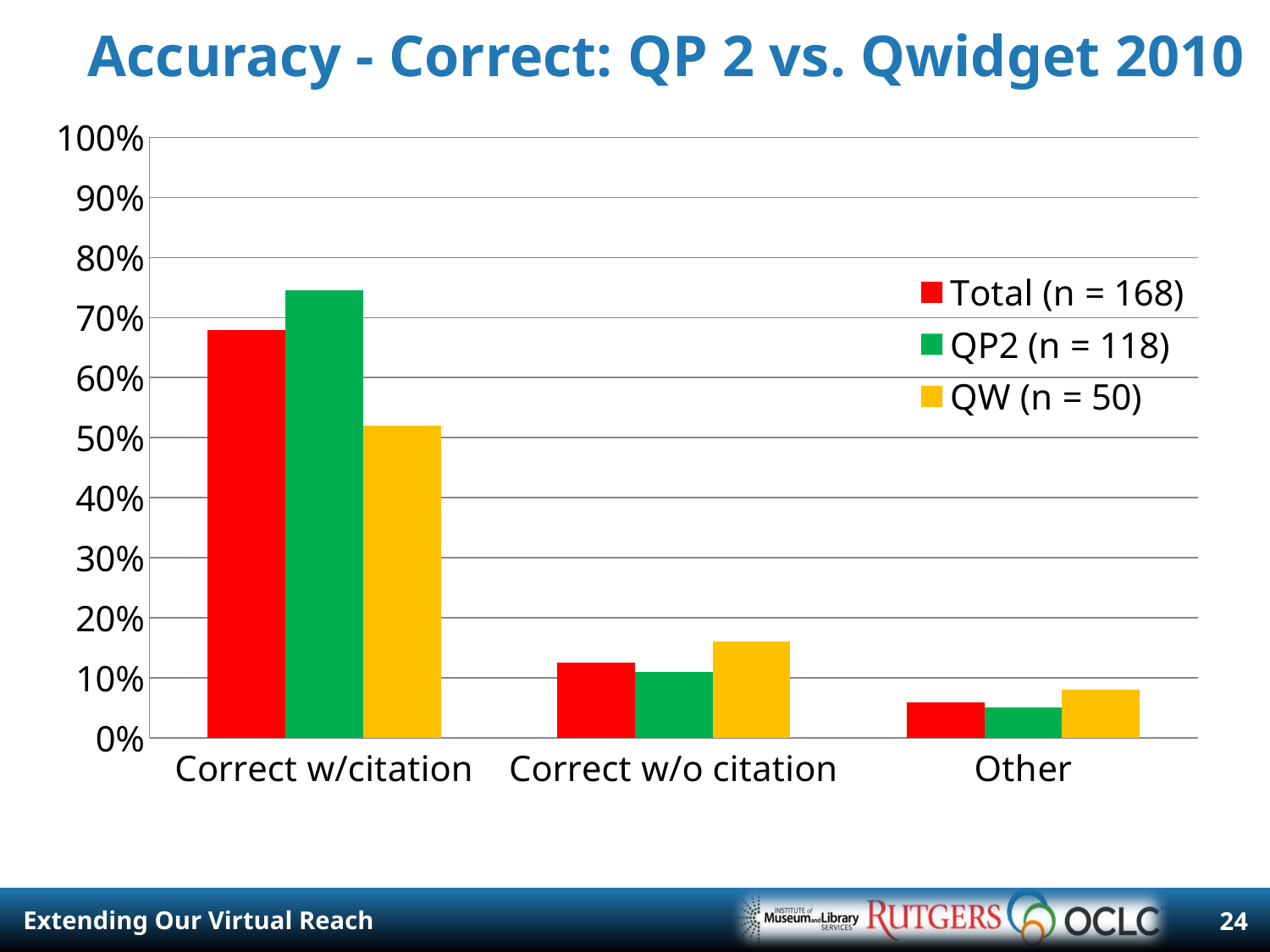
How many series does the legend list? 3 Is the value for QW (n = 50) in Correct w/citation greater or less than 60%? less In the Correct w/o citation category, which is larger: QP2 (n = 118) or QW (n = 50)? QW (n = 50) Is the value for QP2 (n = 118) in Correct w/citation greater or less than 70%? greater Which category has the lowest value for QW (n = 50)? Other What colour represents the Total (n = 168) series? red Is the value for QP2 (n = 118) in Other greater or less than 10%? less Which series has the highest value for Correct w/citation? QP2 (n = 118) How many categories are shown on the x axis? 3 Which category has the highest value for Total (n = 168)? Correct w/citation What kind of chart is shown on the slide? bar chart